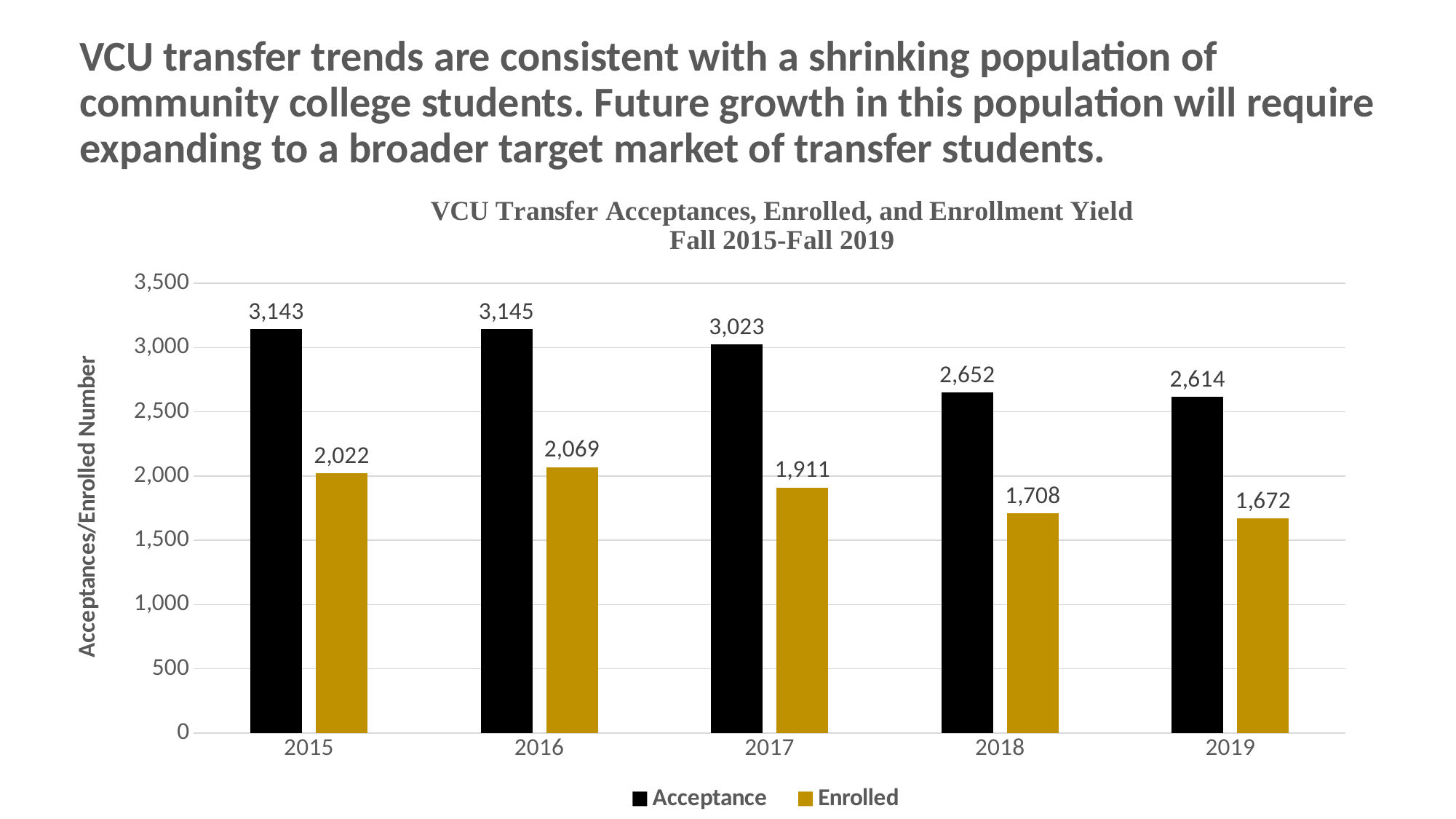
How many series does the legend list? 2 Do the Enrolled values generally rise or fall from 2016 to 2019? fall In which year was the Enrolled value highest? 2016 Is the Acceptance value for 2018 greater or less than 3,000? less What was the Enrolled value in 2016? 2,069 In which year was the Acceptance value lowest? 2019 How many years are shown on the x axis? 5 What kind of chart is shown on the slide? bar chart Which is larger: the Enrolled value in 2015 or the Enrolled value in 2017? 2015 What was the Enrolled value in 2019? 1,672 What was the Acceptance value in 2017? 3,023 What is the difference between Acceptance and Enrolled in 2018? 944